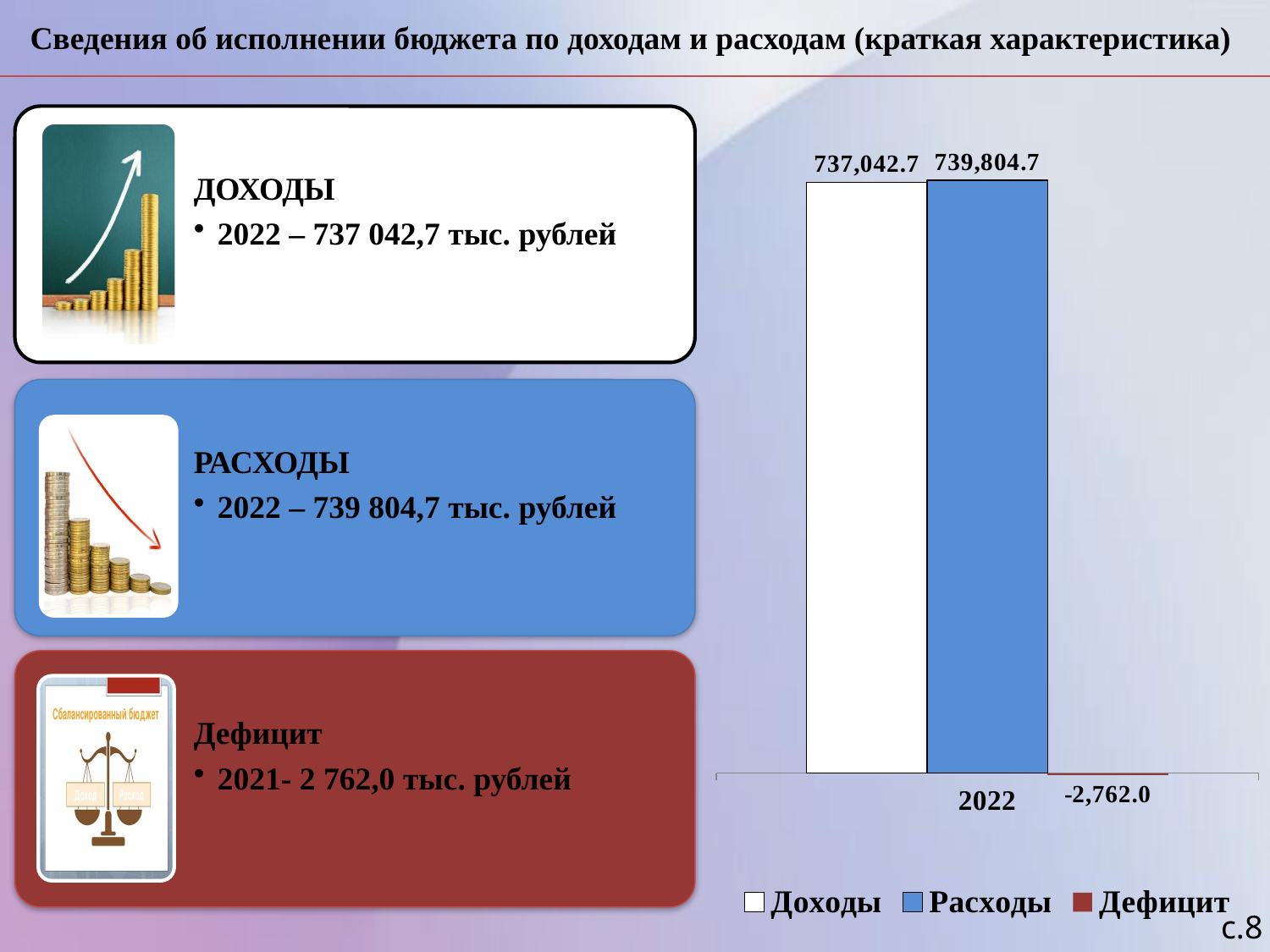
How many series does the chart legend list? 3 Which is larger in the chart, Доходы or Расходы? Расходы What colour is the Расходы bar in the chart? Blue How many categories are shown on the x axis of the chart? 1 What type of chart is shown on the slide? Bar chart Which series has the lowest value in the chart? Дефицит What year is labelled on the x axis of the chart? 2022 What is the value of the Расходы bar in the chart? 739,804.7 Which series has the highest value in the chart? Расходы What is the difference between the Расходы and Доходы values in the chart? 2,762.0 What is the value of the Доходы bar in the chart? 737,042.7 What is the value shown for Дефицит in the chart? -2,762.0